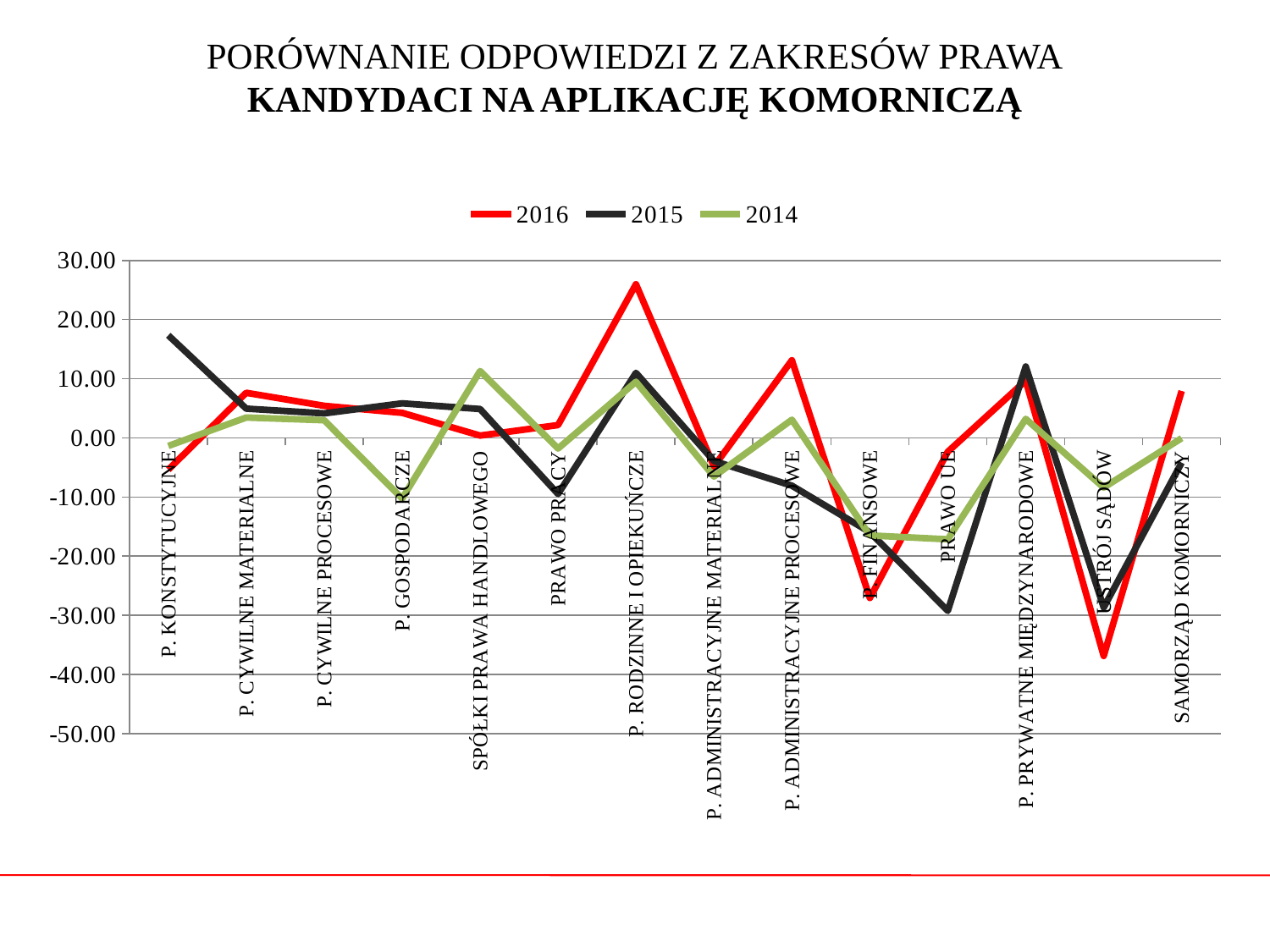
At P. KONSTYTUCYJNE, which series has the larger value, 2015 or 2016? 2015 Is the 2014 value for P. GOSPODARCZE greater or less than 0.00? less Is the 2016 value for USTRÓJ SĄDÓW greater or less than -30.00? less Which category has the lowest value for the 2016 series? USTRÓJ SĄDÓW Which colour is used for the 2014 series line? green What kind of chart is shown on the slide? line chart Which category has the highest value for the 2015 series? P. KONSTYTUCYJNE How many categories are plotted along the x axis? 14 Is the 2016 value for P. RODZINNE I OPIEKUŃCZE greater or less than 20.00? greater Which category has the highest value for the 2016 series? P. RODZINNE I OPIEKUŃCZE How many series does the legend list? 3